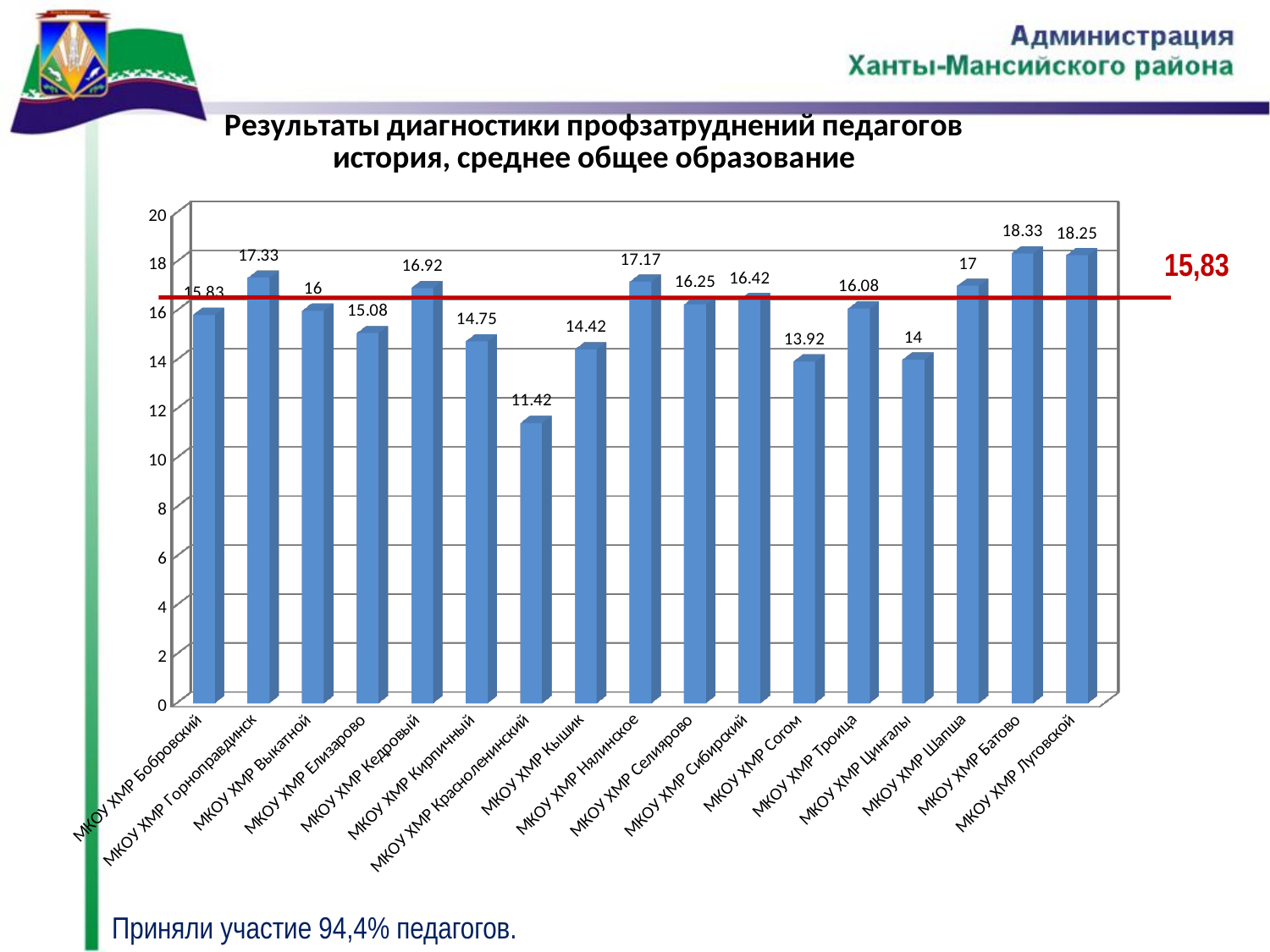
What kind of chart is shown on the slide? bar chart What is the value for МКОУ ХМР Шапша? 17 What is the value for МКОУ ХМР Красноленинский? 11.42 What is the difference between the values for МКОУ ХМР Батово and МКОУ ХМР Луговской? 0.08 Is the value for МКОУ ХМР Согом greater or less than 14? less Which category has the lowest value? МКОУ ХМР Красноленинский What is the difference between the values for МКОУ ХМР Сибирский and МКОУ ХМР Селиярово? 0.17 Which is larger, the value for МКОУ ХМР Нялинское or МКОУ ХМР Кедровый? МКОУ ХМР Нялинское How many categories are shown on the x axis? 17 What is the value for МКОУ ХМР Горноправдинск? 17.33 What value is marked by the red horizontal line on the chart? 15,83 Which category has the highest value? МКОУ ХМР Батово